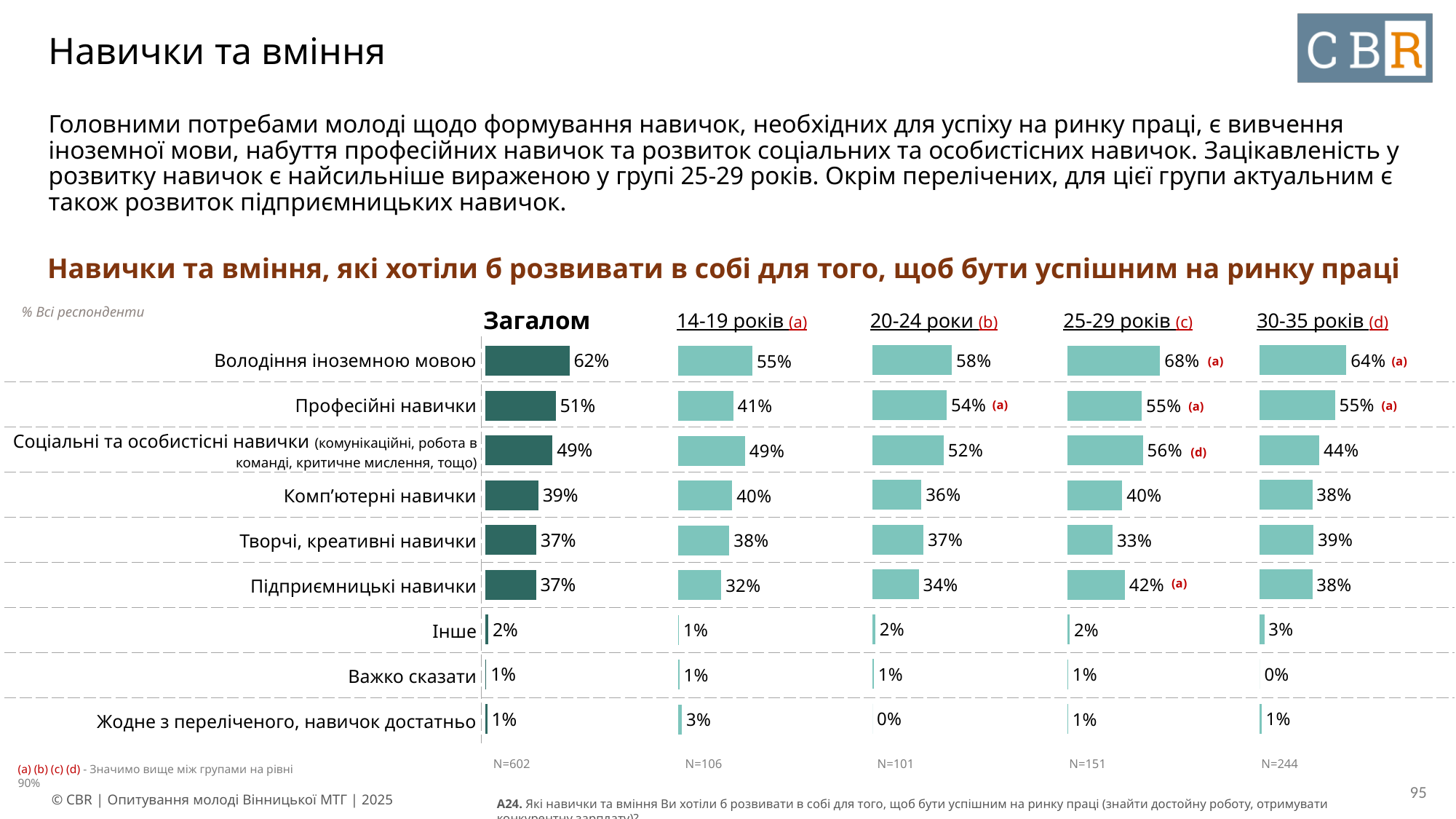
What is the value for "Підприємницькі навички" in the "25-29 років" column? 42% What is the value for "Професійні навички" in the "14-19 років" column? 41% What type of chart is shown on the slide? Bar chart What is the difference between the "Загалом" values for "Володіння іноземною мовою" and "Професійні навички"? 11% Which is larger for "Соціальні та особистісні навички": the "25-29 років" value or the "30-35 років" value? 25-29 років What is the difference between the "25-29 років" and "14-19 років" values for "Підприємницькі навички"? 10% How many categories (rows) are shown in the chart? 9 How many columns (respondent groups) does the chart show? 5 Which category has the highest value in the "Загалом" column? Володіння іноземною мовою Which age group has the highest value for "Володіння іноземною мовою"? 25-29 років What is the value for "Володіння іноземною мовою" in the "Загалом" column? 62% Which age group has the lowest value for "Важко сказати"? 30-35 років